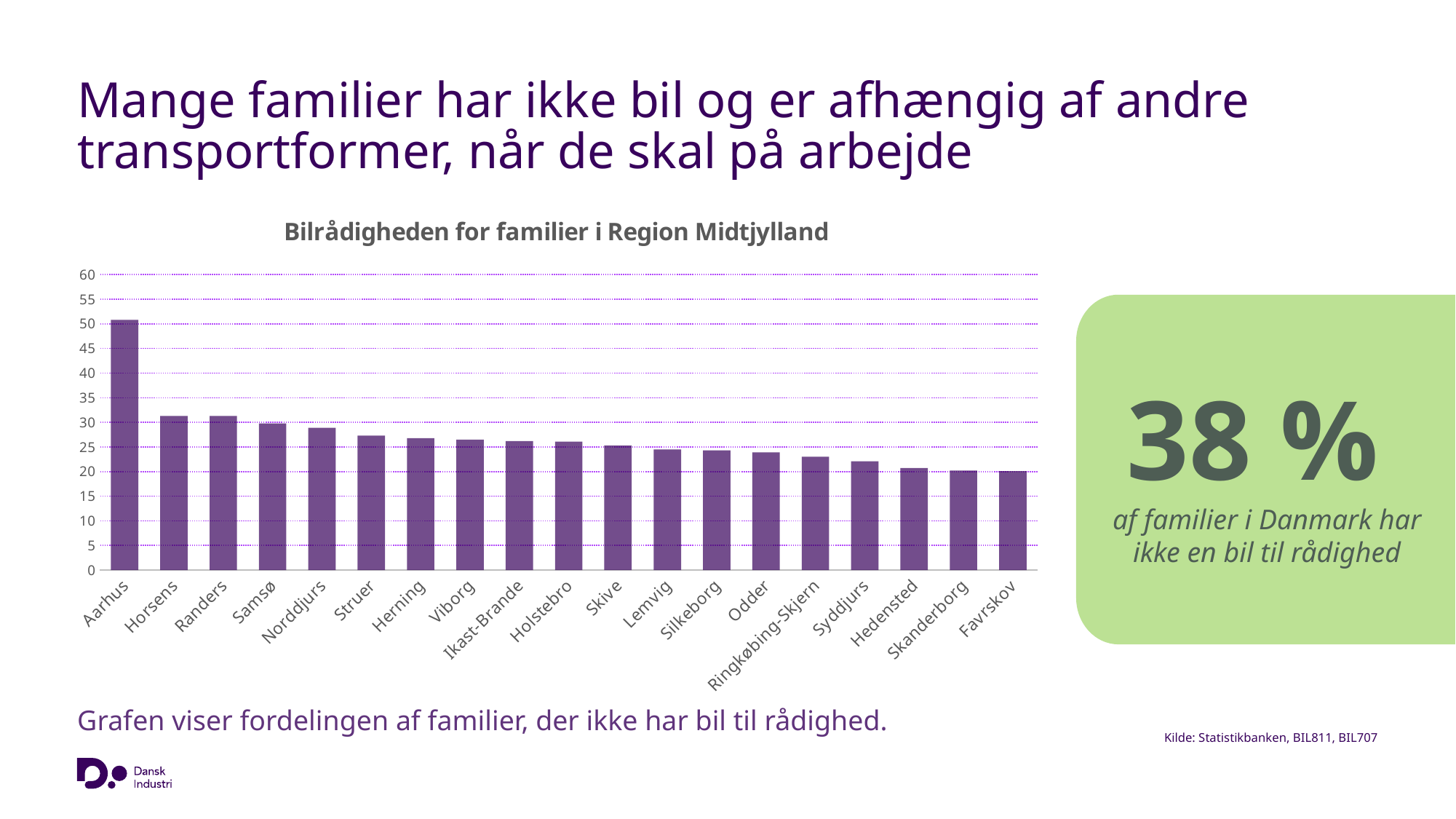
Is the value for Favrskov greater or less than 25? less What kind of chart is shown on the slide? Bar chart Is the value for Samsø greater or less than 35? less Which has a larger value, Samsø or Favrskov? Samsø How many municipalities are shown on the x axis of the chart? 19 Which municipality has the highest value in the chart? Aarhus What is the title of the chart? Bilrådigheden for familier i Region Midtjylland Do the values generally rise or fall from left to right along the x axis? Fall Is the value for Aarhus greater or less than 45? greater Which has a larger value, Aarhus or Horsens? Aarhus